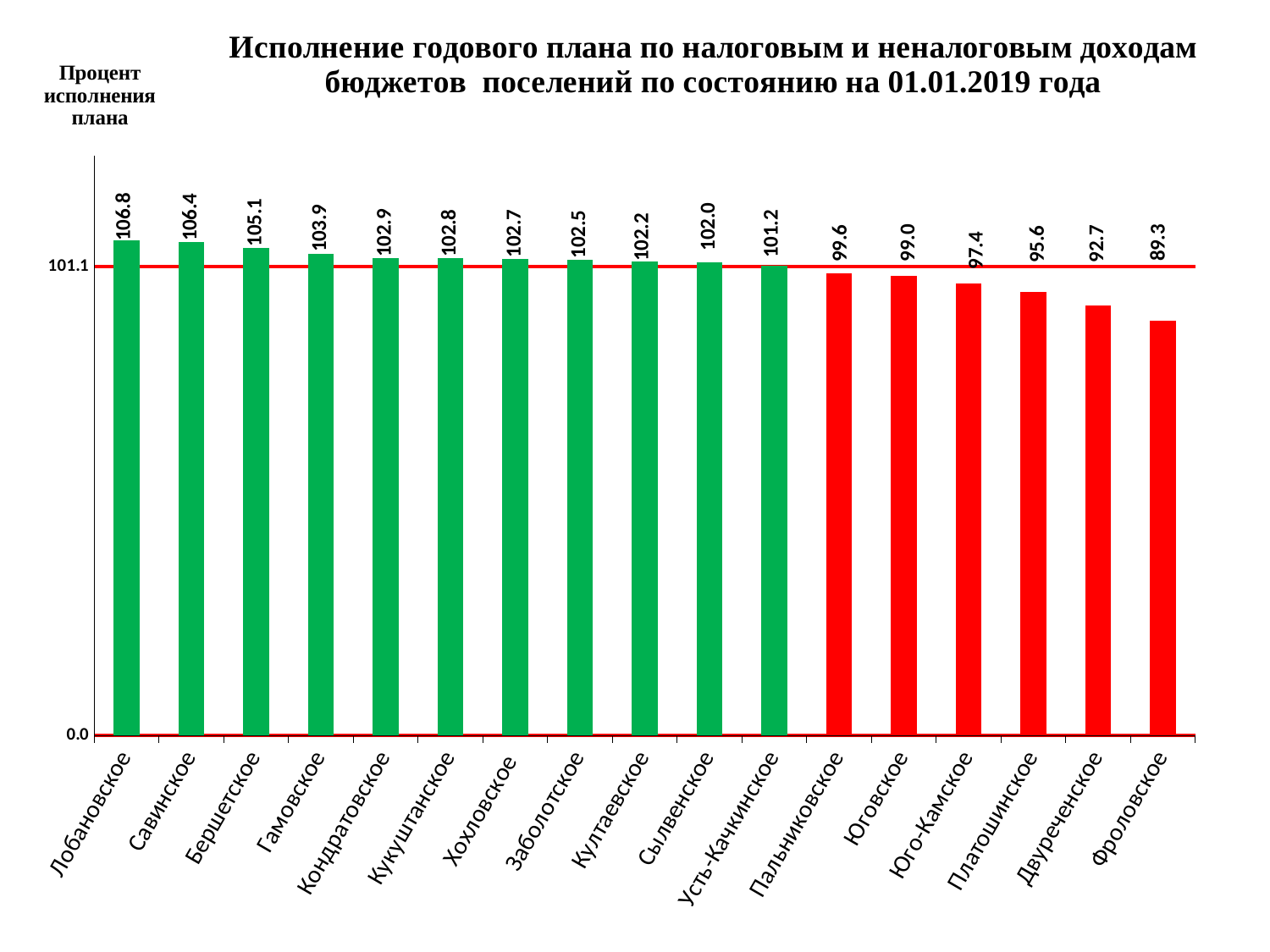
What kind of chart is shown on the slide? Bar chart What is the difference between the values for Лобановское and Фроловское? 17.5 What is the value for Фроловское? 89.3 What is the value for Усть-Качкинское? 101.2 How many categories are shown on the x axis? 17 What is the difference between the values for Гамовское and Платошинское? 8.3 What is the value for Юго-Камское? 97.4 Which category has the highest value? Лобановское Which is larger, the value for Савинское or the value for Бершетское? Савинское Which category has the lowest value? Фроловское What is the value for Лобановское? 106.8 What value is marked by the horizontal red line on the chart? 101.1